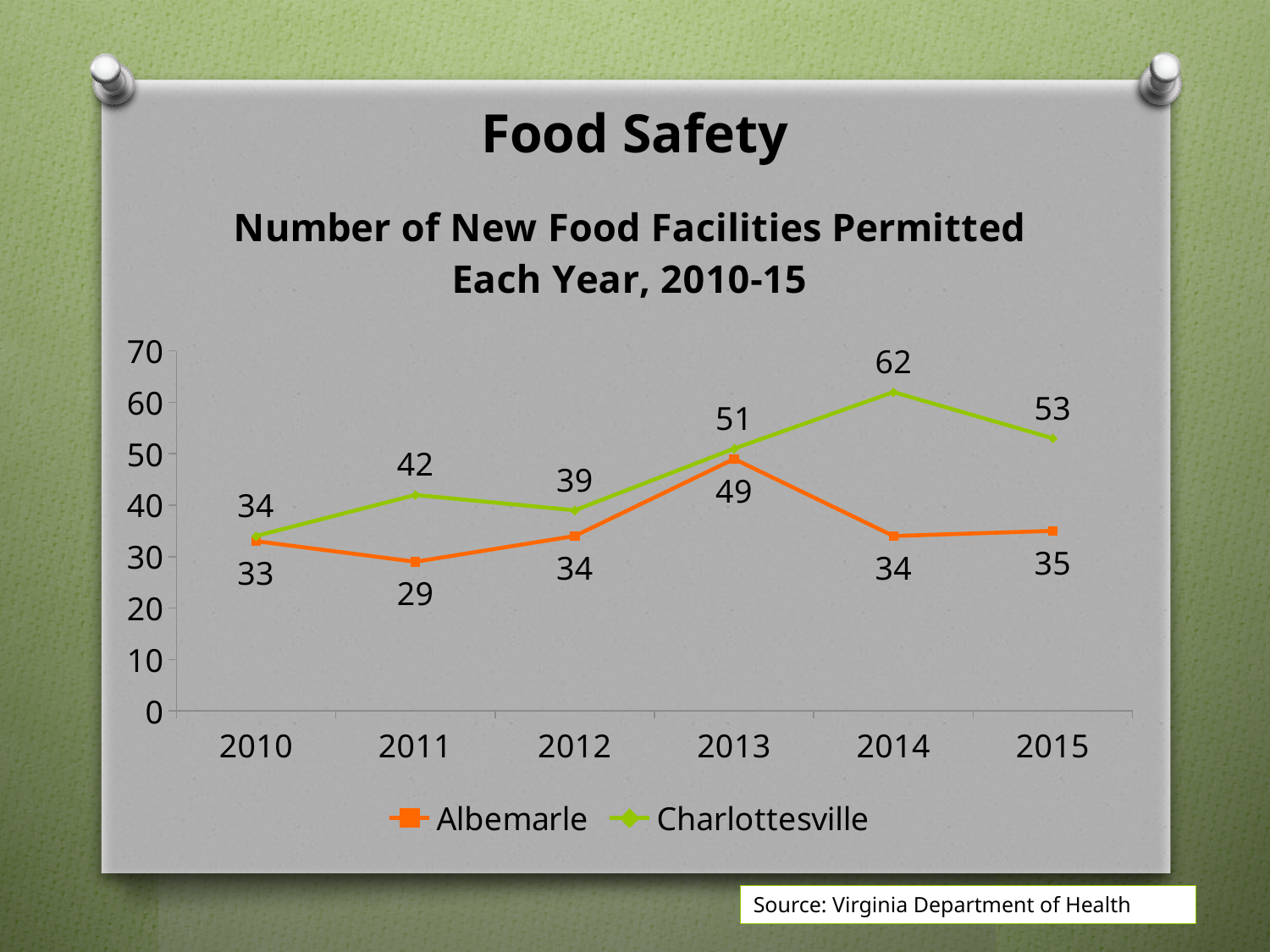
What is the difference between Charlottesville and Albemarle in 2014? 28 In which year is the Albemarle value lowest? 2011 What is the value for Albemarle in 2011? 29 What is the value for Charlottesville in 2014? 62 Does the Charlottesville value rise or fall from 2014 to 2015? fall Which is larger in 2015, Albemarle or Charlottesville? Charlottesville What is the source cited for the chart? Virginia Department of Health In which year is the Charlottesville value highest? 2014 What kind of chart is shown? line chart What is the value for Albemarle in 2013? 49 How many years are shown on the x axis? 6 How many series does the legend list? 2